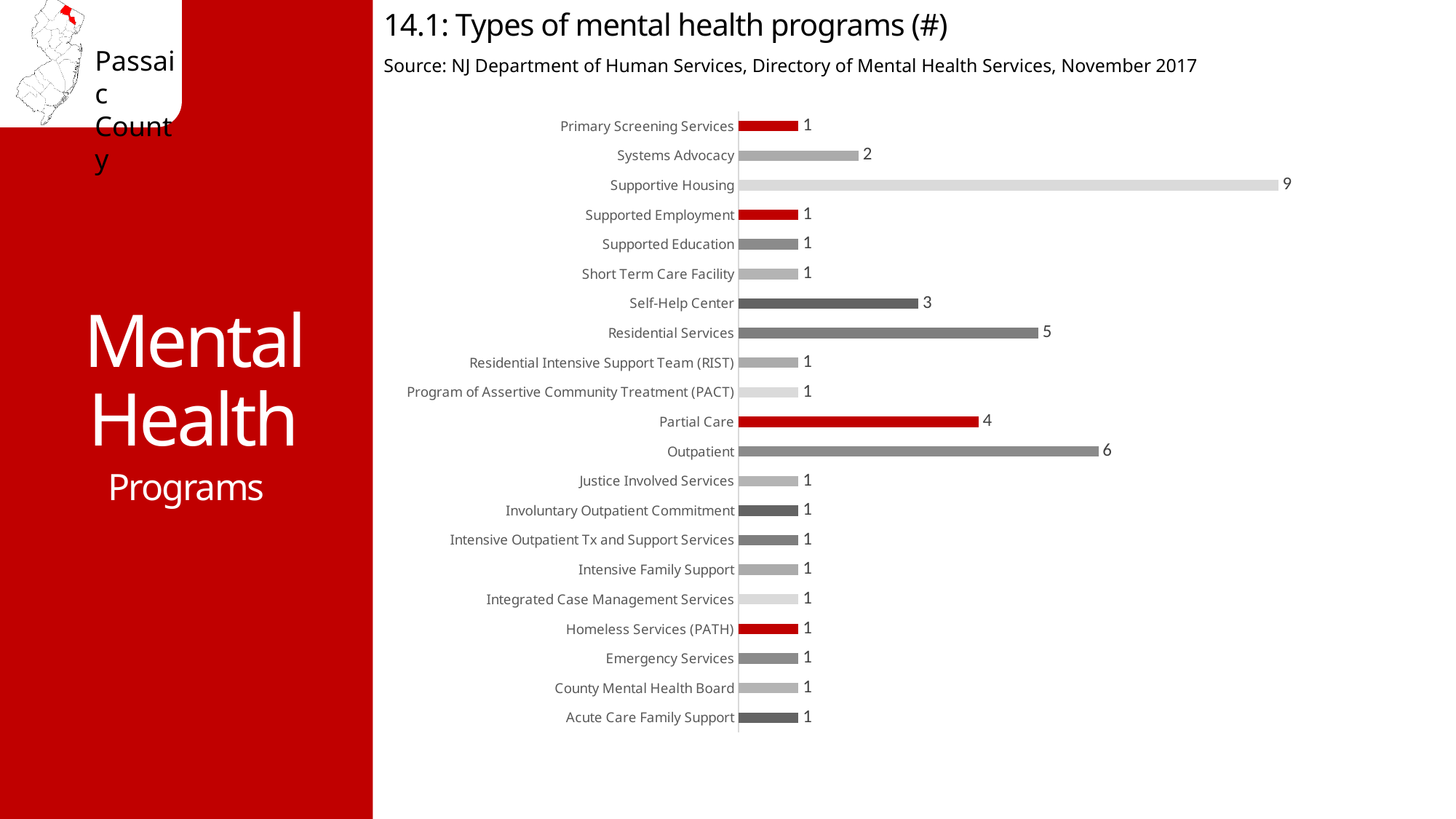
What is the value for Residential Services? 5 How many program types are shown in the chart? 21 What is the value for Partial Care? 4 What is the value for Self-Help Center? 3 What is the value for Outpatient? 6 What is the difference between the values for Supportive Housing and Outpatient? 3 What is the title of the chart? 14.1: Types of mental health programs (#) Which is larger, the value for Residential Services or the value for Partial Care? Residential Services What is the value for Supportive Housing? 9 What kind of chart is shown on the slide? Bar chart Which program type has the highest number of programs? Supportive Housing What is the value for Systems Advocacy? 2